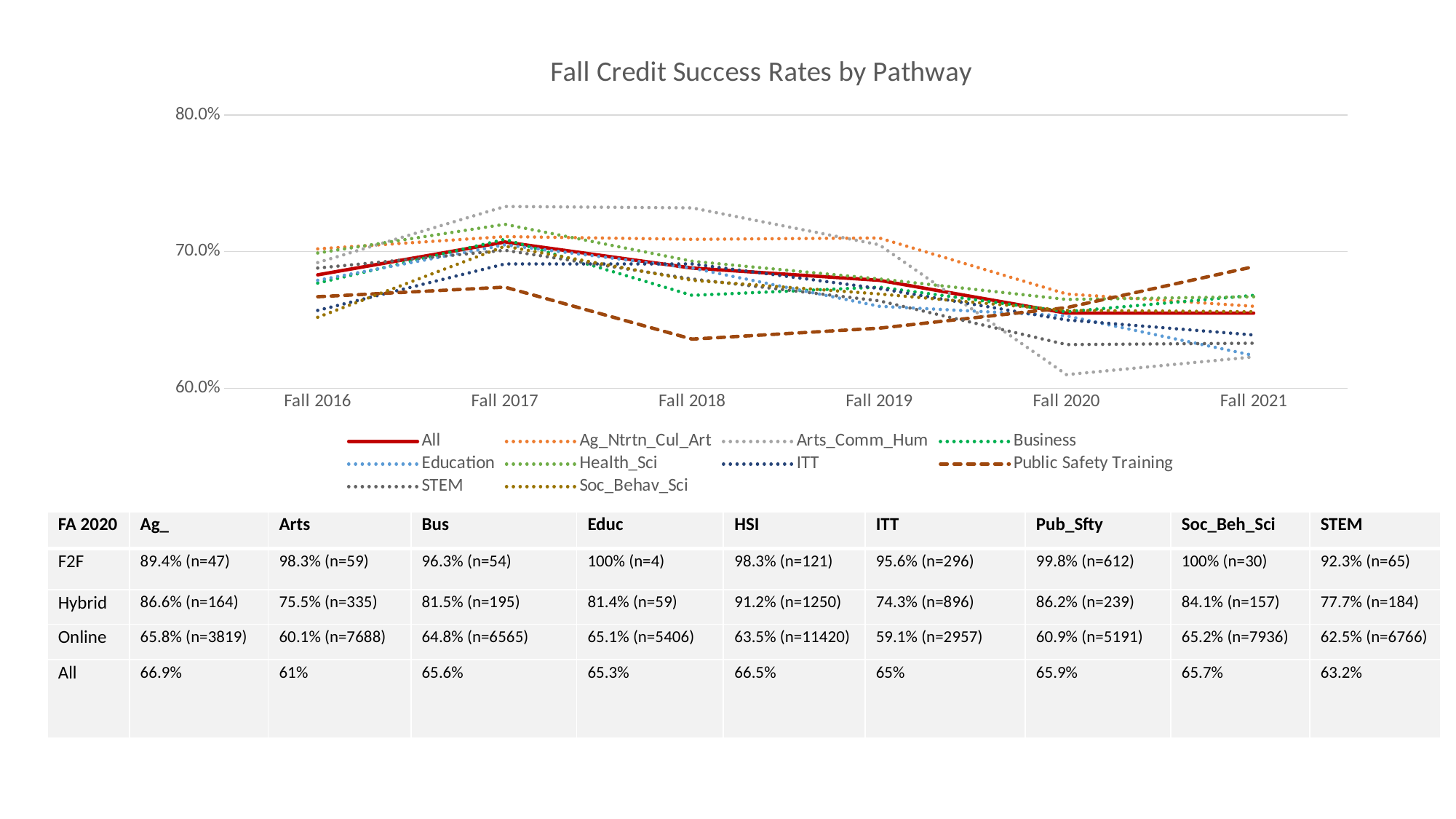
How many fall terms are plotted along the x axis of the chart? 6 At Fall 2018, which is larger: Arts_Comm_Hum or Public Safety Training? Arts_Comm_Hum Which series has the lowest value at Fall 2018? Public Safety Training What is the title of the chart? Fall Credit Success Rates by Pathway Is the value for Public Safety Training at Fall 2018 greater or less than 70.0%? less What type of chart is shown on the slide? line chart Is the value for Arts_Comm_Hum at Fall 2017 greater or less than 70.0%? greater Which series is drawn as a solid red line in the chart? All Which series has the highest value at Fall 2017? Arts_Comm_Hum How many series does the chart legend list? 10 Which series has the lowest value at Fall 2020? Arts_Comm_Hum Does the All series rise or fall from Fall 2017 to Fall 2020? fall